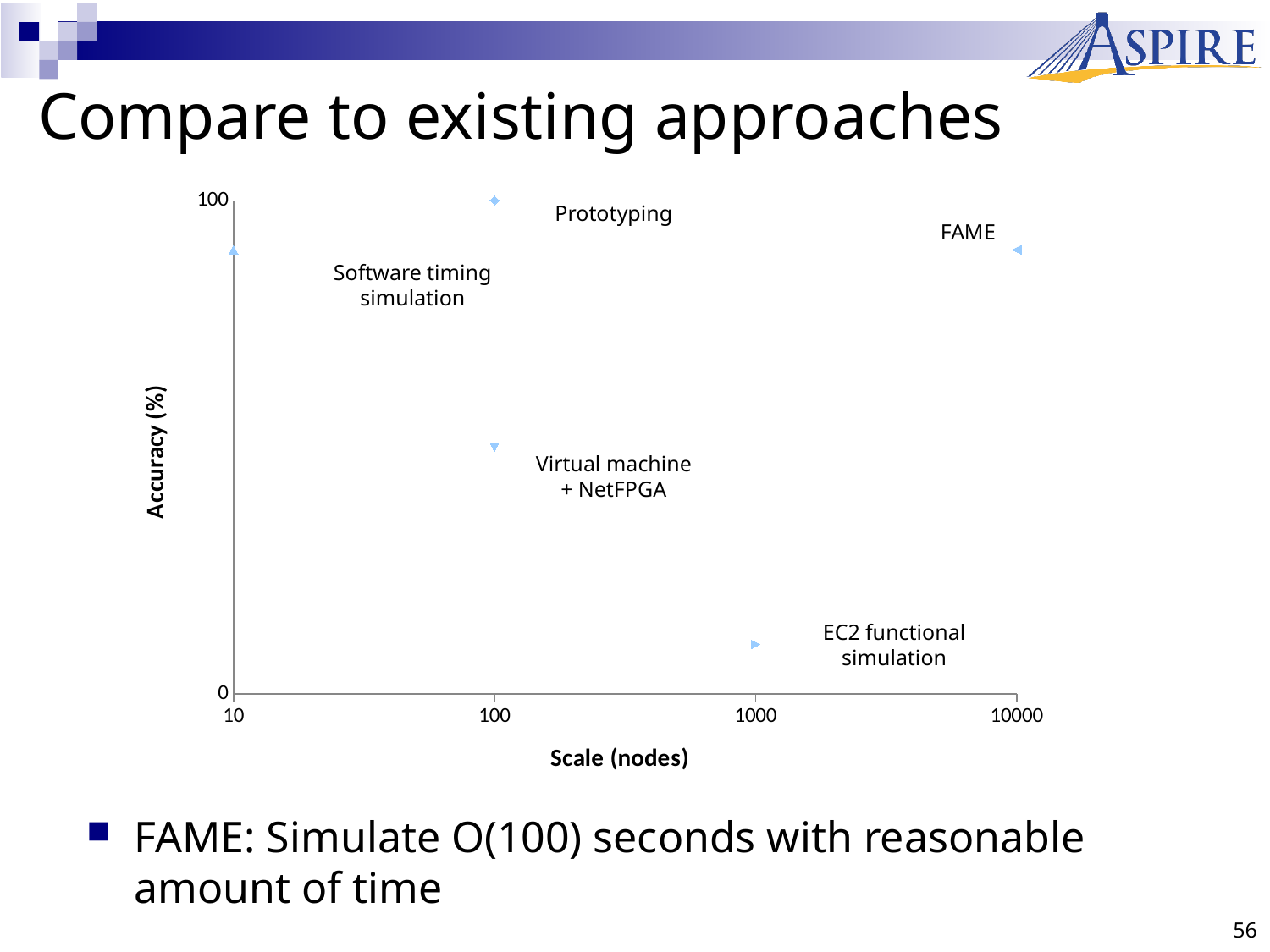
What kind of chart is shown on the slide? scatter chart How many labeled data points are plotted on the chart? 5 Which approach is plotted at the smallest scale (nodes)? Software timing simulation Which approach has the highest accuracy on the chart? Prototyping At what scale (nodes) is FAME plotted? 10000 At what scale (nodes) is EC2 functional simulation plotted? 1000 Which approach has the lowest accuracy on the chart? EC2 functional simulation What is the title of the y axis? Accuracy (%) What is the title of the x axis? Scale (nodes) Which has higher accuracy: Virtual machine + NetFPGA or EC2 functional simulation? Virtual machine + NetFPGA What accuracy (%) is plotted for Prototyping? 100 Which approach is plotted at the largest scale (nodes)? FAME